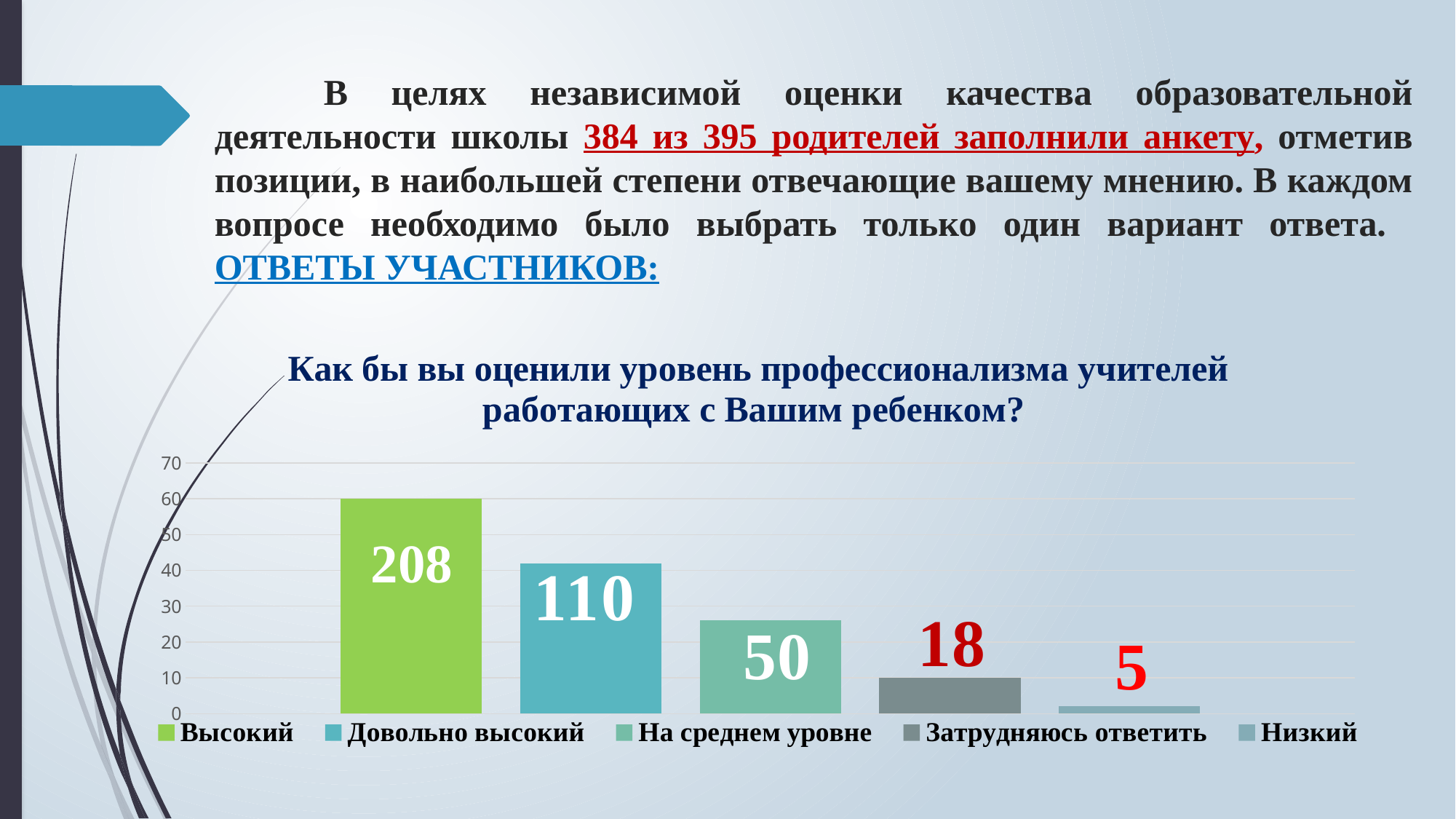
Do the bar values rise or fall from left to right across the chart? fall Which category has the highest value? Высокий What type of chart is shown on the slide? bar chart Which is larger, the value for "На среднем уровне" or the value for "Затрудняюсь ответить"? На среднем уровне How many entries does the legend list? 5 What is the data label for the "Высокий" bar? 208 What is the data label for the "На среднем уровне" bar? 50 Which category has the lowest value? Низкий What is the data label for the "Низкий" bar? 5 What is the data label for the "Затрудняюсь ответить" bar? 18 What is the difference between the values for "Высокий" and "Довольно высокий"? 98 What is the data label for the "Довольно высокий" bar? 110